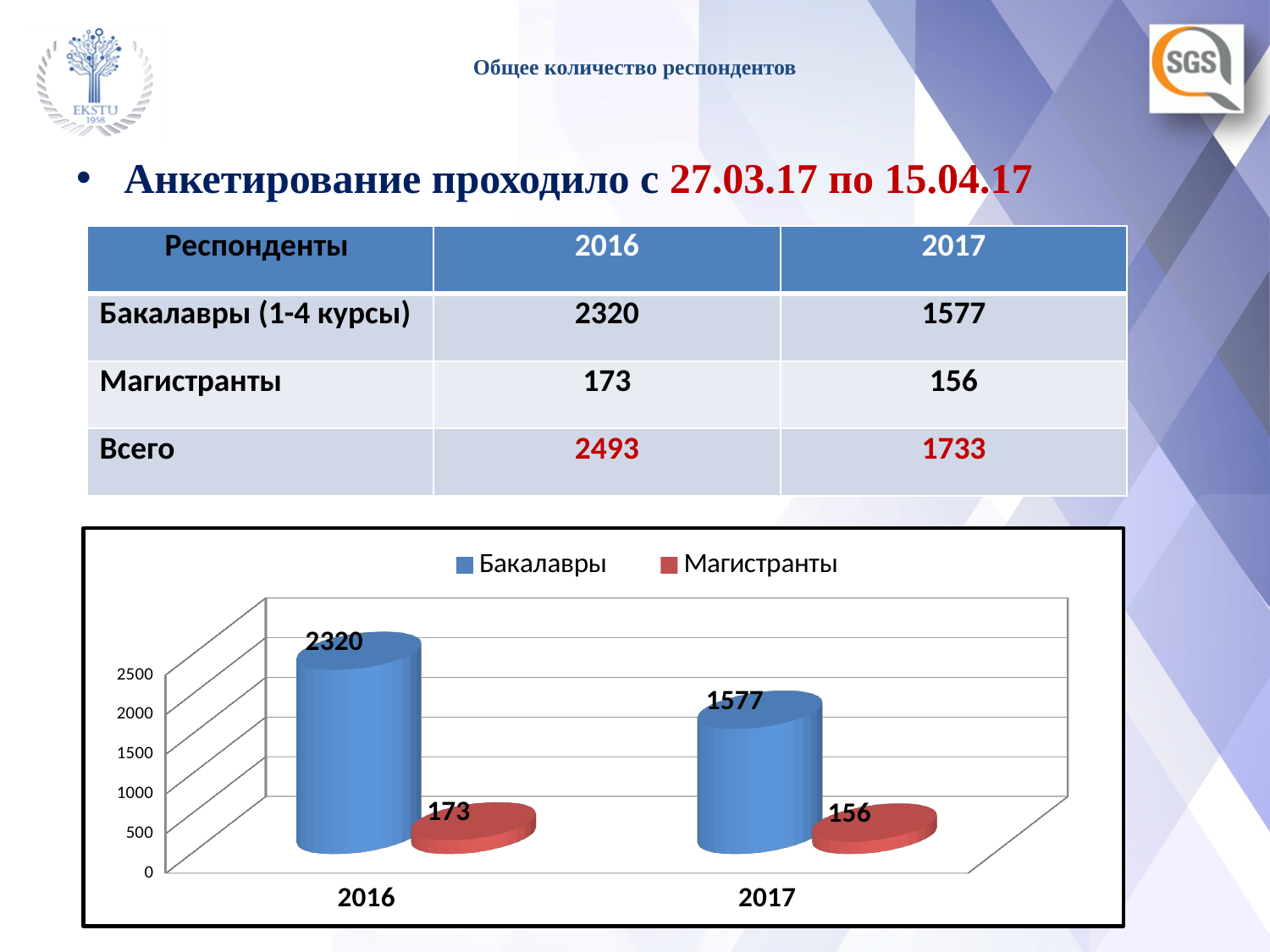
How many series does the legend list? 2 Which colour represents Магистранты in the chart? red How many categories are shown on the x axis? 2 What is the value for Бакалавры in 2017? 1577 Does the value for Бакалавры rise or fall from 2016 to 2017? fall What is the value for Магистранты in 2016? 173 Which year has the higher value for Бакалавры? 2016 What kind of chart is shown on the slide? bar chart What is the value for Бакалавры in 2016? 2320 What is the value for Магистранты in 2017? 156 What is the difference between the Бакалавры values for 2016 and 2017? 743 What is the difference between the Магистранты values for 2016 and 2017? 17